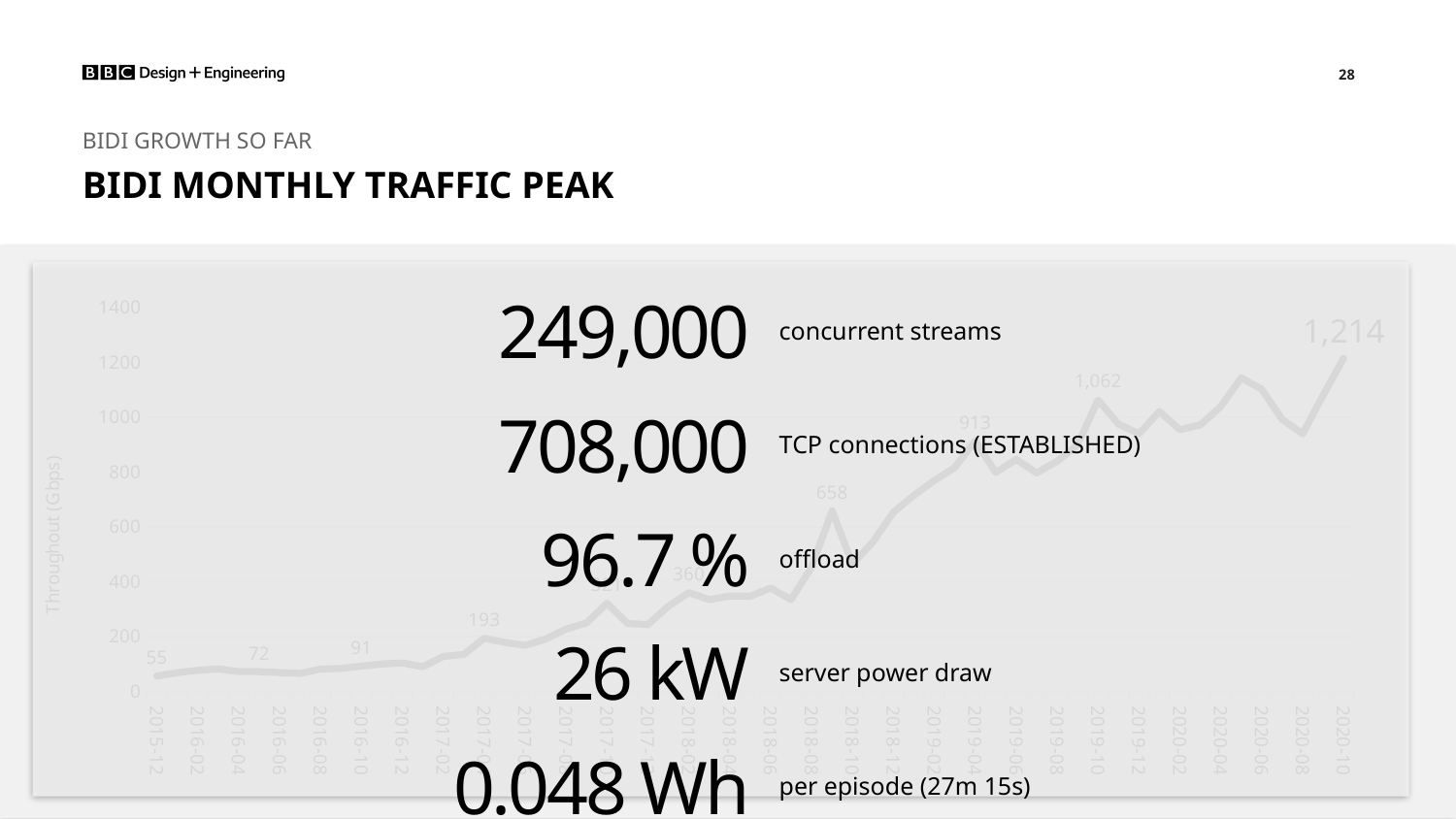
What is the value of the last data point on the chart, at 2020-10? 1,214 Is the value at 2020-10 greater or less than 1200? greater What is the highest labelled value on the chart? 1,214 What kind of chart is shown on the slide? line chart Which is larger, the value at 2015-12 or the value at 2020-10? 2020-10 What is the difference between the labelled values 1,214 and 1,062 on the chart? 152 Do the values on the chart generally rise or fall from 2015-12 to 2020-10? rise What is the lowest labelled value on the chart? 55 Is the value at 2015-12 greater or less than 200? less What is the value of the first data point on the chart, at 2015-12? 55 What is the title of the chart? BIDI MONTHLY TRAFFIC PEAK What is the label on the vertical axis of the chart? Throughout (Gbps)